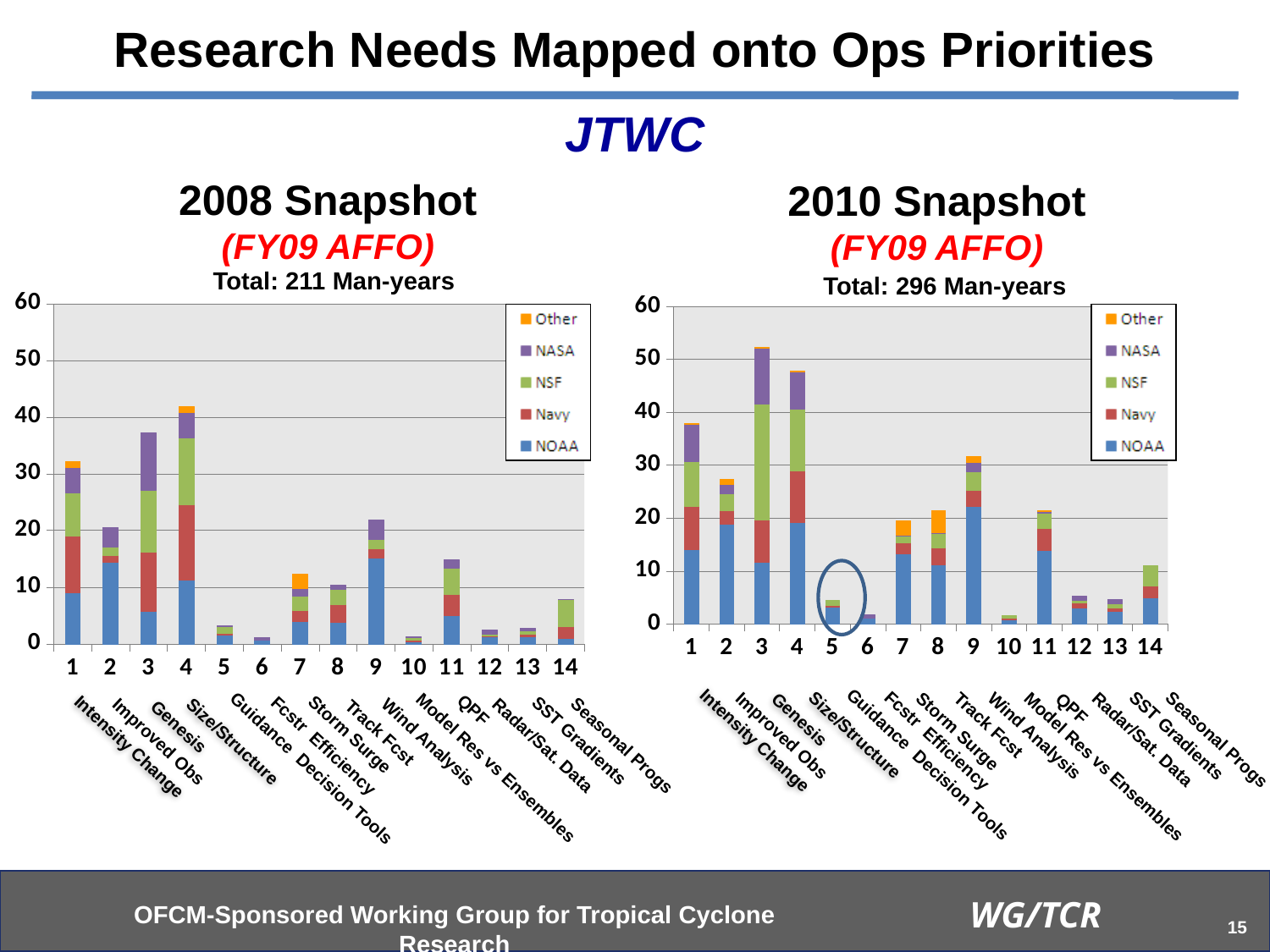
In the 2010 Snapshot chart, which has the taller stacked bar, category 1 or category 2? category 1 How many numbered categories are shown on the x axis of the 2008 Snapshot chart? 14 In the 2010 Snapshot chart, is the total for category 3 greater or less than 50? greater In the 2010 Snapshot chart, is the total for category 5 greater or less than 10? less In the 2008 Snapshot chart, which numbered category has the tallest stacked bar? 4 (Size/Structure) What kind of chart is the 2008 Snapshot chart? stacked bar chart In the 2008 Snapshot chart, is the total for category 4 greater or less than 40? greater How many series does the legend of the 2010 Snapshot chart list? 5 What total in man-years is printed above the 2010 Snapshot chart? 296 Man-years In the 2010 Snapshot chart, which numbered category has the tallest stacked bar? 3 (Genesis) In the 2008 Snapshot chart, which has the taller stacked bar, category 2 or category 3? category 3